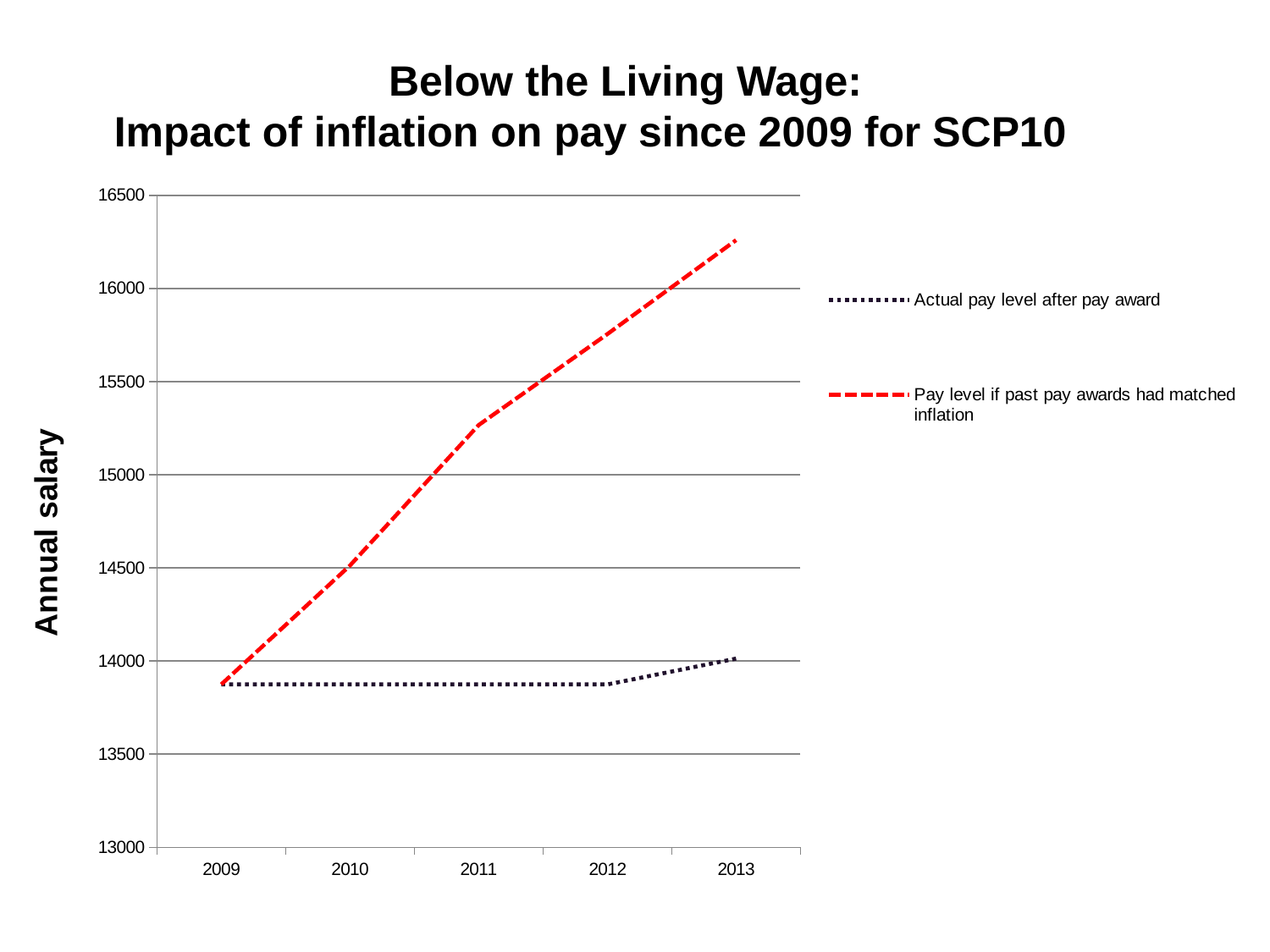
In 2013, which series has the larger value: 'Actual pay level after pay award' or 'Pay level if past pay awards had matched inflation'? Pay level if past pay awards had matched inflation Does the 'Pay level if past pay awards had matched inflation' series rise or fall from 2009 to 2013? Rise Is the 2013 value for 'Pay level if past pay awards had matched inflation' greater or less than 16000? greater How many years are plotted along the x axis? 5 Is the 2009 value for 'Actual pay level after pay award' greater or less than 14000? less Which series is drawn with a red dashed line? Pay level if past pay awards had matched inflation In which year is the 'Pay level if past pay awards had matched inflation' series lowest? 2009 In which year is the 'Pay level if past pay awards had matched inflation' series highest? 2013 How many series does the legend list? 2 Is the 2011 value for 'Pay level if past pay awards had matched inflation' greater or less than 15000? greater What type of chart is shown on the slide? Line chart What is the label on the vertical axis of the chart? Annual salary